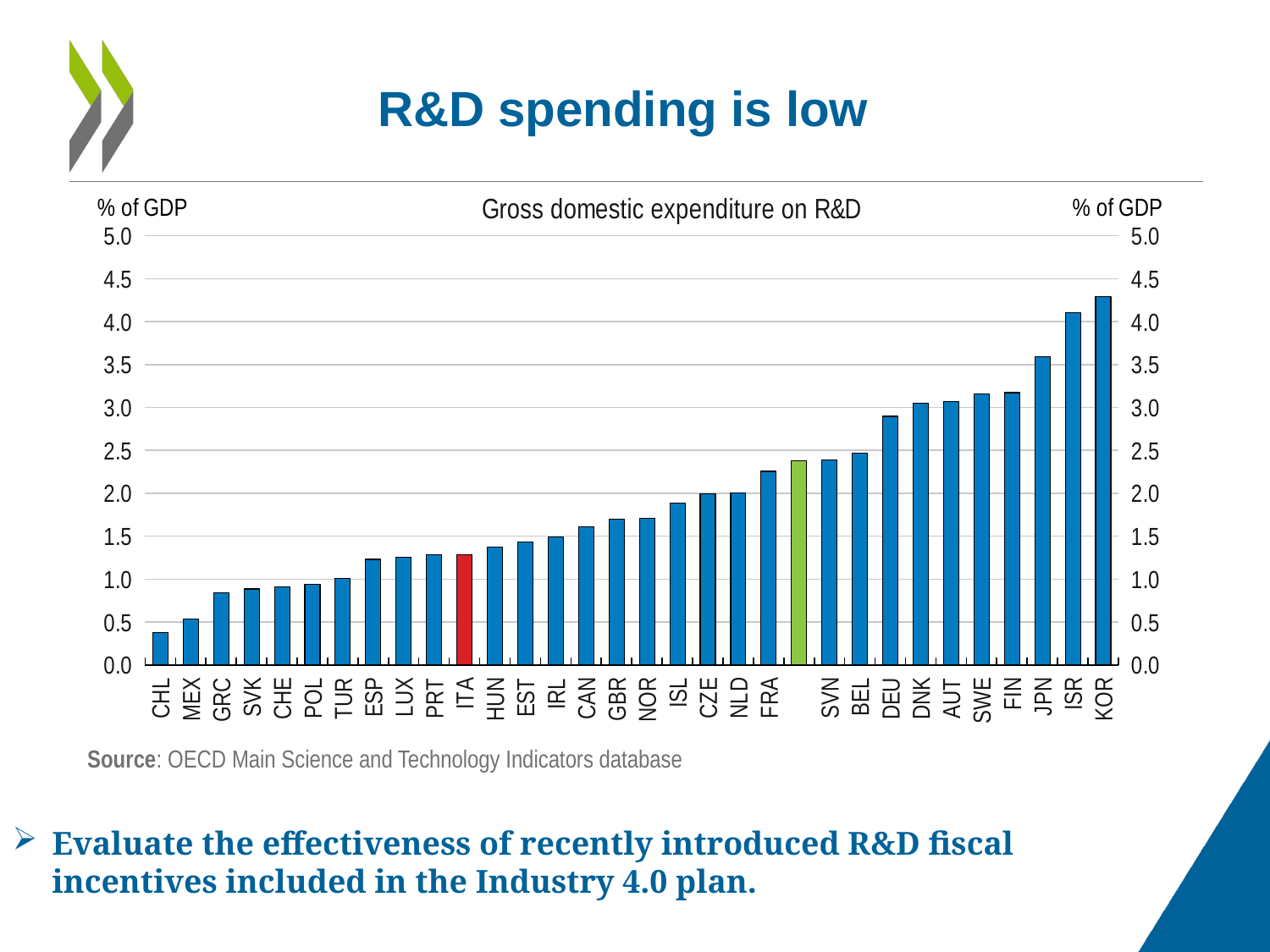
Which country has the highest gross domestic expenditure on R&D as a % of GDP? KOR Which has a higher R&D expenditure as a % of GDP, ITA or FRA? FRA Is the value for CHL greater or less than 0.5? less Is the value for FRA greater or less than 2.0? greater Which country has the lowest gross domestic expenditure on R&D as a % of GDP? CHL Is the value for ITA greater or less than 1.0? greater Which country's bar is coloured red? ITA What kind of chart is shown on the slide? Bar chart Do the bar values rise or fall moving from left to right along the x axis? Rise